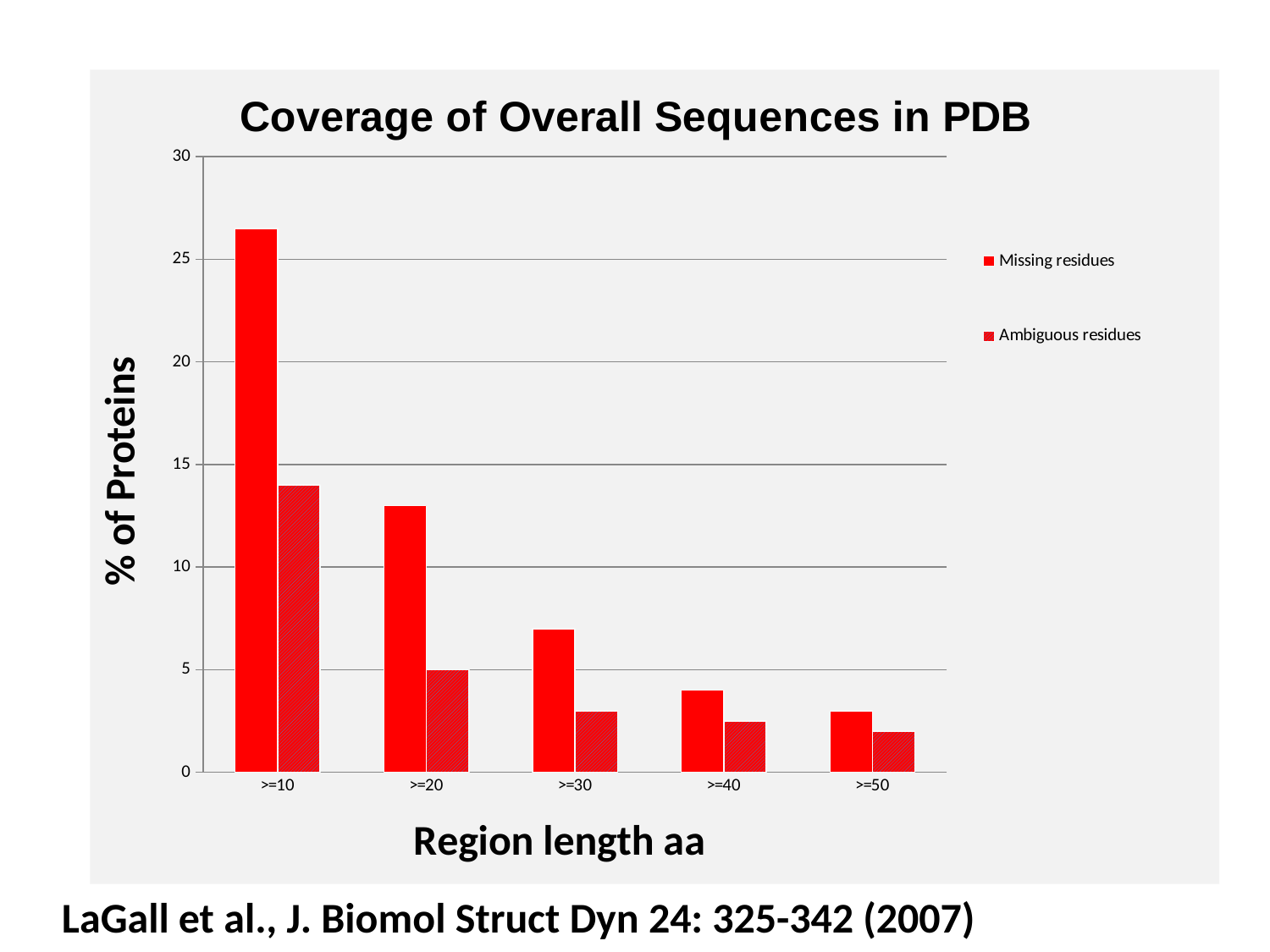
Do the values for Missing residues rise or fall as region length increases along the x axis? fall What kind of chart is shown on the slide? bar chart Is the value for Missing residues at >=20 greater or less than 10? greater Which region length category has the lowest value for Missing residues? >=50 At region length >=10, which series has the larger value, Missing residues or Ambiguous residues? Missing residues Which region length category has the highest value for Missing residues? >=10 How many series does the legend list? 2 What is the title of the chart? Coverage of Overall Sequences in PDB Is the value for Missing residues at >=10 greater or less than 25? greater Is the value for Ambiguous residues at >=10 greater or less than 15? less How many region length categories are shown on the x axis? 5